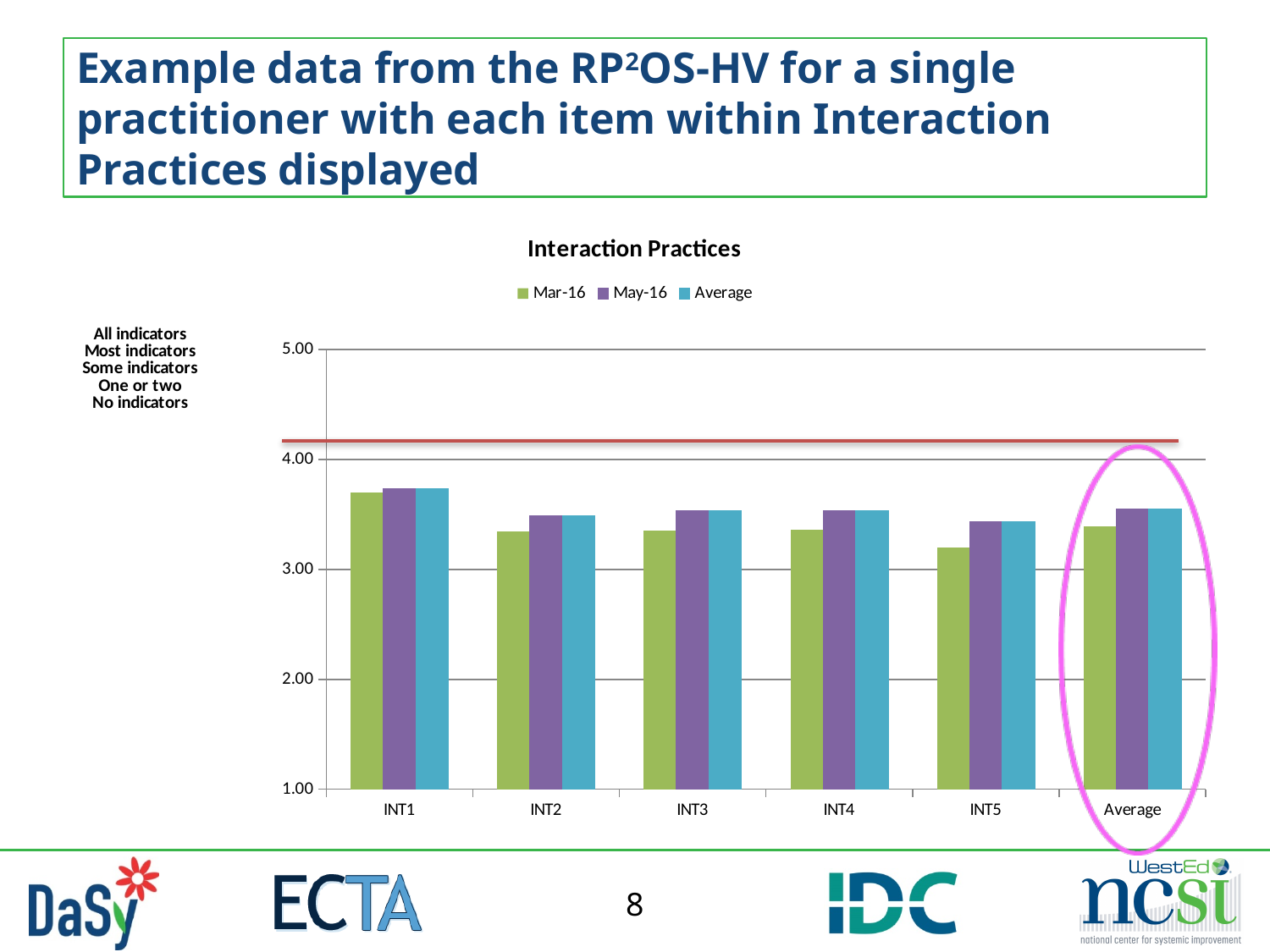
Is the Mar-16 value for INT1 greater or less than 4.00? less What kind of chart is shown on the slide? bar chart For INT5, which is larger: the Mar-16 value or the May-16 value? May-16 Which is larger: the Mar-16 value for INT1 or the Mar-16 value for INT5? INT1 Is the Mar-16 value for INT5 greater or less than 3.00? greater How many categories are shown along the x axis of the Interaction Practices chart? 6 Which series are listed in the legend of the chart? Mar-16, May-16, Average Which category has the highest May-16 value? INT1 Which category has the lowest Mar-16 value? INT5 Which category has the highest Mar-16 value? INT1 What is the title of the chart? Interaction Practices How many series does the legend of the Interaction Practices chart list? 3